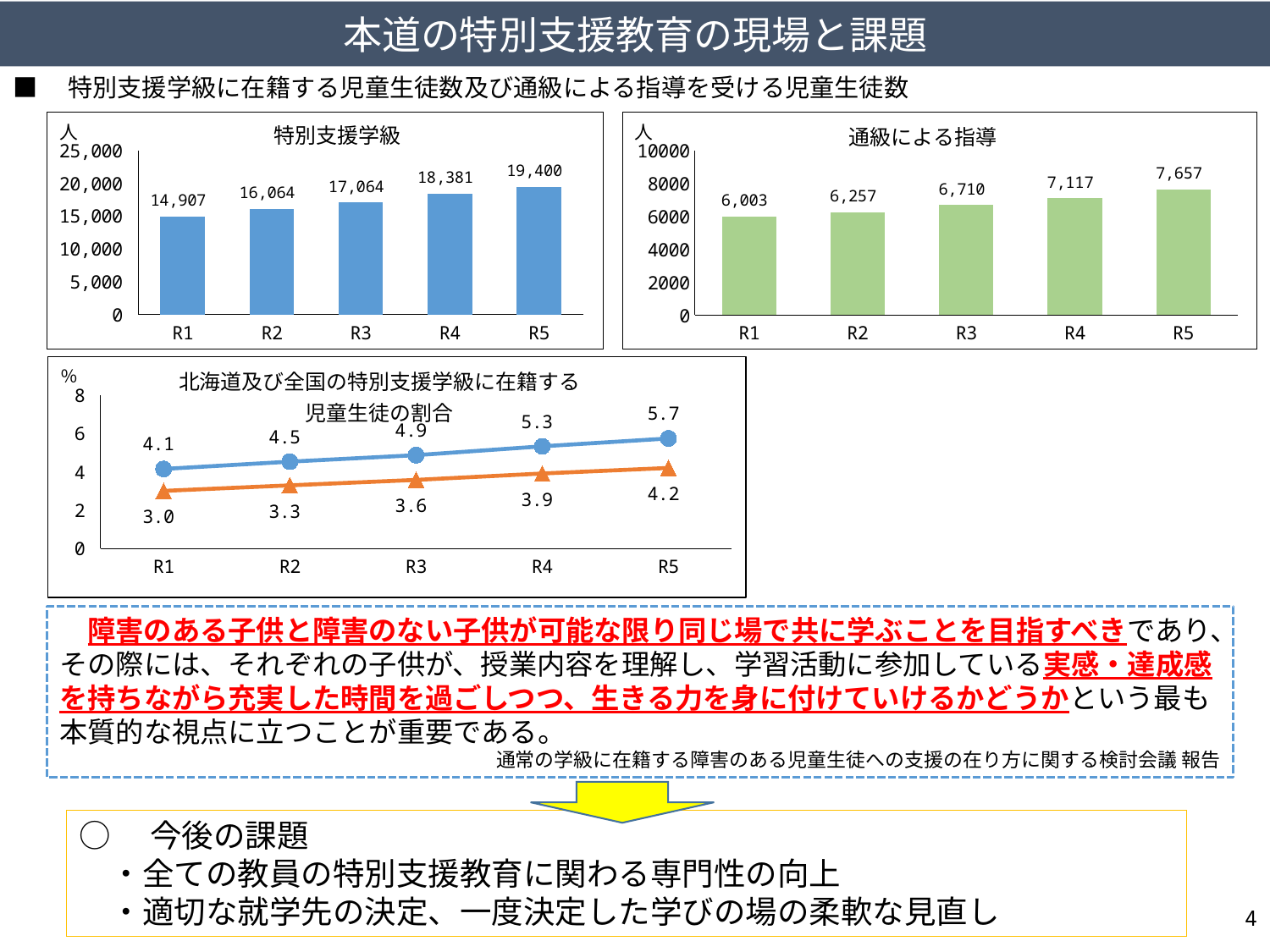
In the 特別支援学級 chart, what is the difference between the R5 and R1 values? 4,493 What kind of chart is the 通級による指導 chart? Bar chart In the 通級による指導 chart, how many bars are plotted? 5 In the 特別支援学級 chart, do the values rise or fall from R1 to R5? Rise In the 通級による指導 chart, what is the difference between the R4 and R2 values? 860 In the line chart at the bottom left, what is the difference between the upper and lower line values at R1? 1.1 In the 特別支援学級 chart, what is the value for R5? 19,400 In the 通級による指導 chart, what is the value for R3? 6,710 In the line chart at the bottom left, what is the value of the upper (blue) line at R5? 5.7 In the 通級による指導 chart, which year has the lowest value? R1 In the 特別支援学級 chart, what is the value for R1? 14,907 In the line chart at the bottom left, what is the value of the lower (orange) line at R3? 3.6